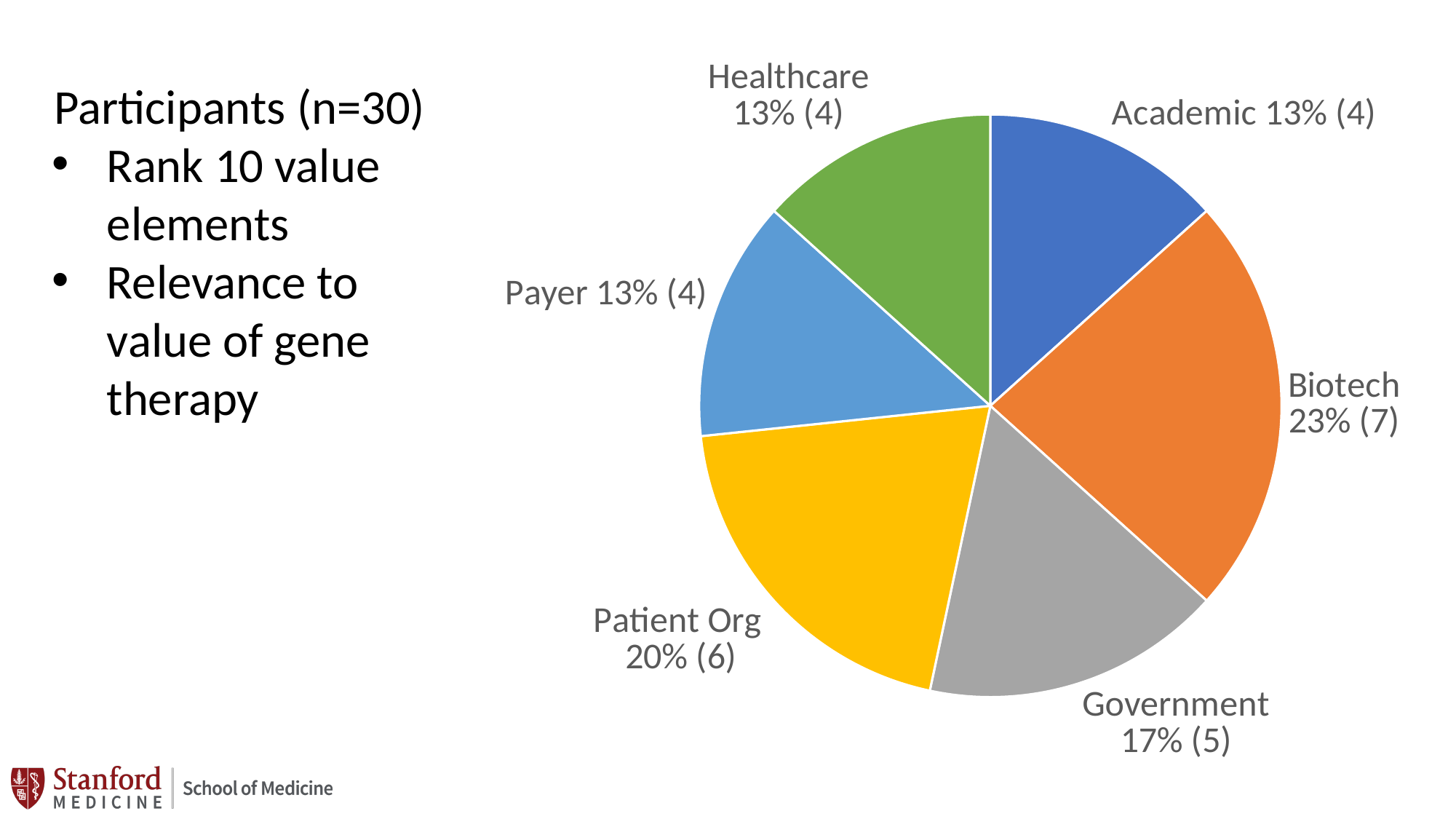
How many participants are from Government? 5 How many more participants are from Biotech than from Government? 2 What percentage of participants are from Patient Org? 20% Which category has the largest share of participants? Biotech What is the difference in percentage points between Patient Org and Academic? 7 What is the total number of participants shown in the chart? 30 Which category has more participants, Patient Org or Government? Patient Org How many slices does the pie chart have? 6 How many participants are from Payer? 4 What kind of chart is shown on the slide? pie chart What percentage of participants are from Biotech? 23% What colour is the Healthcare slice? green